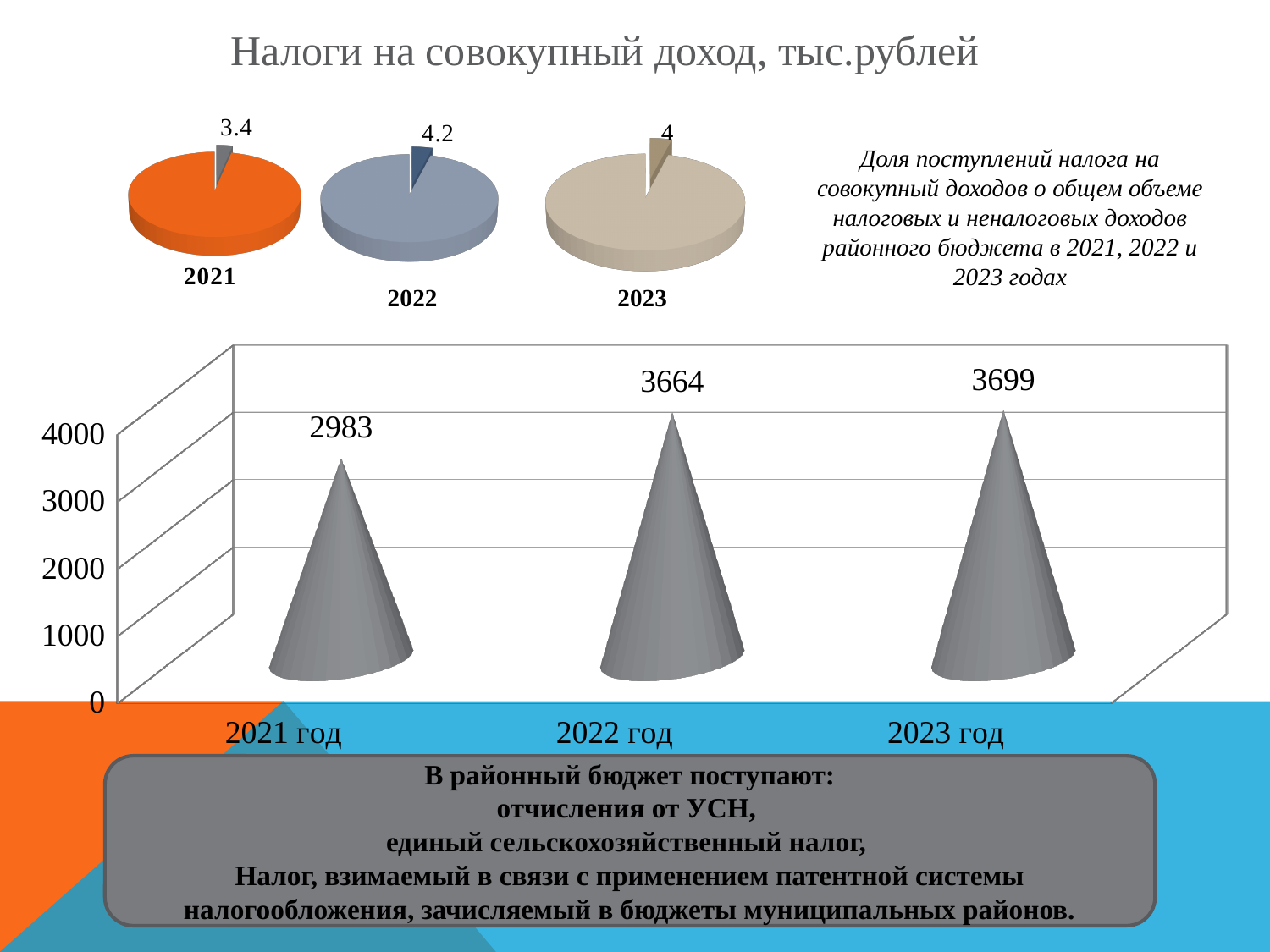
In the bar chart at the bottom of the slide, which is larger: the value for 2022 год or the value for 2023 год? 2023 год In the bar chart at the bottom of the slide, what is the difference between the values for 2023 год and 2022 год? 35 In the bar chart at the bottom of the slide, what is the value for 2023 год? 3699 What kind of chart is the chart at the bottom of the slide showing values for 2021 год, 2022 год and 2023 год? bar chart In the bar chart at the bottom of the slide, which year has the lowest value? 2021 год In the bar chart at the bottom of the slide, what is the difference between the values for 2022 год and 2021 год? 681 How many categories are shown in the bar chart at the bottom of the slide? 3 In the bar chart at the bottom of the slide, what is the value for 2022 год? 3664 In the bar chart at the bottom of the slide, which year has the highest value? 2023 год In the bar chart at the bottom of the slide, do the values rise or fall from 2021 год to 2023 год? rise In the bar chart at the bottom of the slide, what is the value for 2021 год? 2983 In the pie chart labelled 2022, what is the value of the small highlighted slice? 4.2